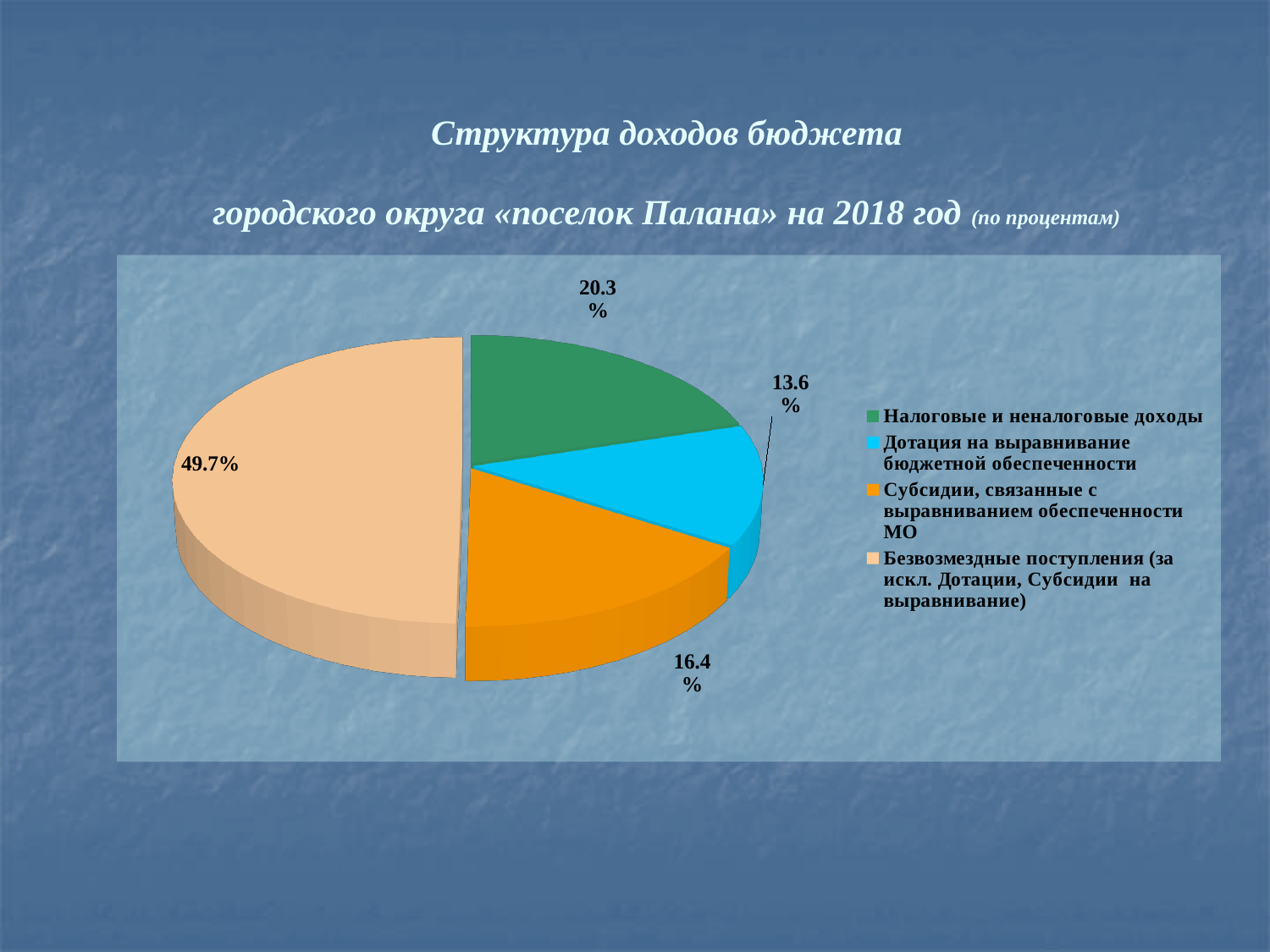
What share of the pie is labelled for "Субсидии, связанные с выравниванием обеспеченности МО"? 16.4% What share of the pie is labelled for "Дотация на выравнивание бюджетной обеспеченности"? 13.6% What colour is the slice for "Безвозмездные поступления (за искл. Дотации, Субсидии на выравнивание)"? Peach (light orange) What is the difference in percentage points between "Налоговые и неналоговые доходы" and "Дотация на выравнивание бюджетной обеспеченности"? 6.7 How many slices does the pie chart have? 4 Which is larger: the slice for "Субсидии, связанные с выравниванием обеспеченности МО" or the slice for "Налоговые и неналоговые доходы"? Налоговые и неналоговые доходы What share of the pie is labelled for "Налоговые и неналоговые доходы"? 20.3% What share of the pie is labelled for "Безвозмездные поступления (за искл. Дотации, Субсидии на выравнивание)"? 49.7% How many entries does the legend list? 4 Which category has the largest slice of the pie? Безвозмездные поступления (за искл. Дотации, Субсидии на выравнивание) What kind of chart is shown on the slide? Pie chart Which category has the smallest slice of the pie? Дотация на выравнивание бюджетной обеспеченности